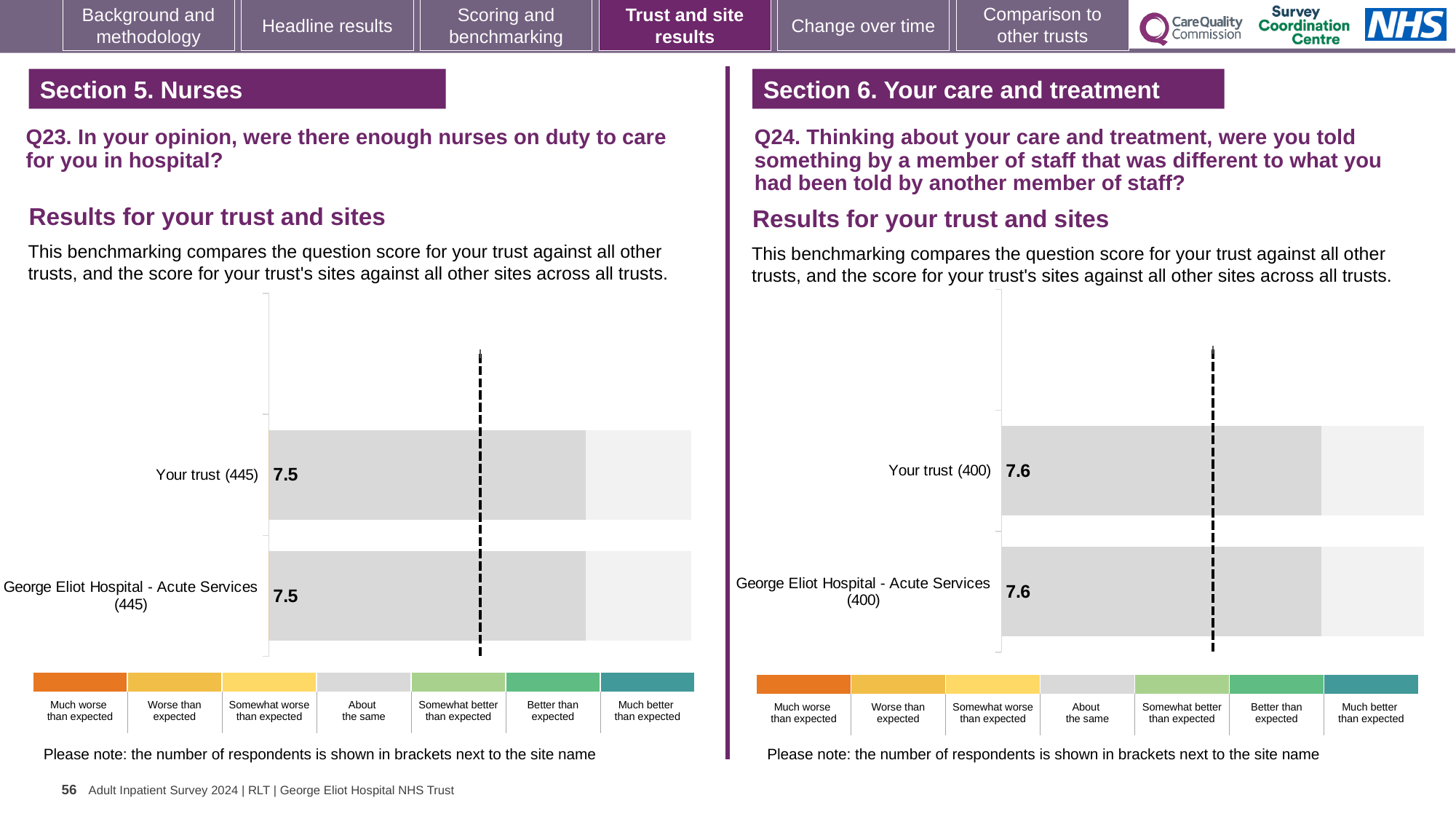
In the Q24 chart on the right, what is the score for George Eliot Hospital - Acute Services? 7.6 In the Q23 chart on the left, what is the score for George Eliot Hospital - Acute Services? 7.5 In the Q23 chart on the left, how many bars are plotted? 2 In the Q23 chart on the left, what is the score for Your trust? 7.5 In the Q24 chart on the right, how many respondents are shown in brackets for George Eliot Hospital - Acute Services? 400 In the Q24 chart on the right, what is the difference between the score for Your trust and the score for George Eliot Hospital - Acute Services? 0 In the Q24 chart on the right, how many bars are plotted? 2 What kind of chart is the Q24 chart on the right? bar chart In the Q23 chart on the left, how many respondents are shown in brackets for Your trust? 445 What kind of chart is the Q23 chart on the left? bar chart In the Q23 chart on the left, what is the difference between the score for Your trust and the score for George Eliot Hospital - Acute Services? 0 In the Q24 chart on the right, what is the score for Your trust? 7.6